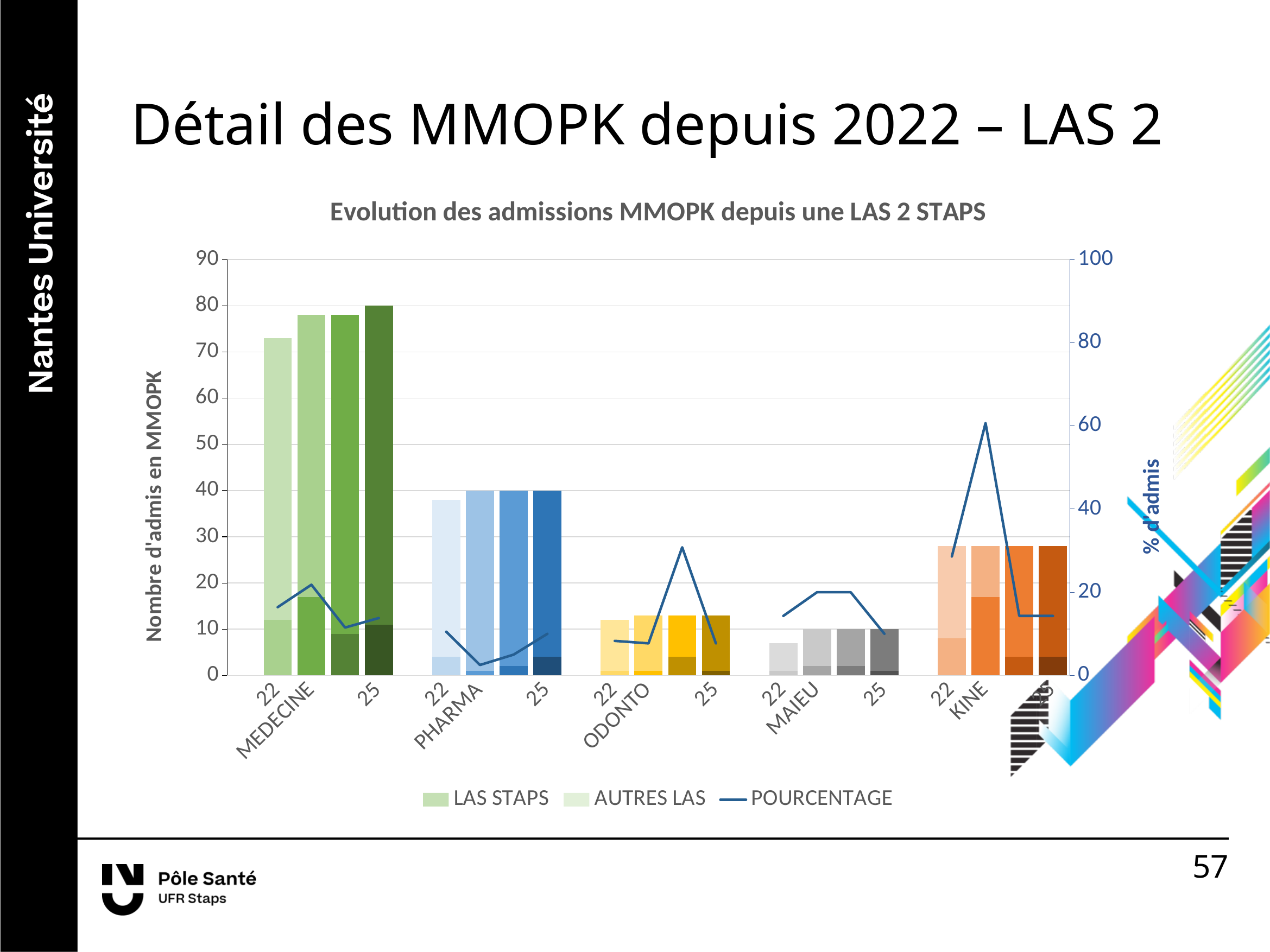
Which discipline group has the tallest bars? MEDECINE How many discipline groups (MEDECINE, PHARMA, etc.) are shown on the x axis? 5 What is the title of the chart? Evolution des admissions MMOPK depuis une LAS 2 STAPS How many series does the legend list? 3 What is the total height of the MEDECINE bar for 25? 80 Which is taller, the MEDECINE bar for 25 or the PHARMA bar for 25? MEDECINE bar for 25 What is the label of the left vertical axis? Nombre d'admis en MMOPK Is the total height of the MEDECINE bar for 22 greater or less than 60? greater What kind of chart is shown on the slide? bar chart with a line What is the total height of the PHARMA bar for 25? 40 What is the total height of the MAIEU bar for 25? 10 Is the peak of the POURCENTAGE line in the KINE group greater or less than 50 on the right axis? greater